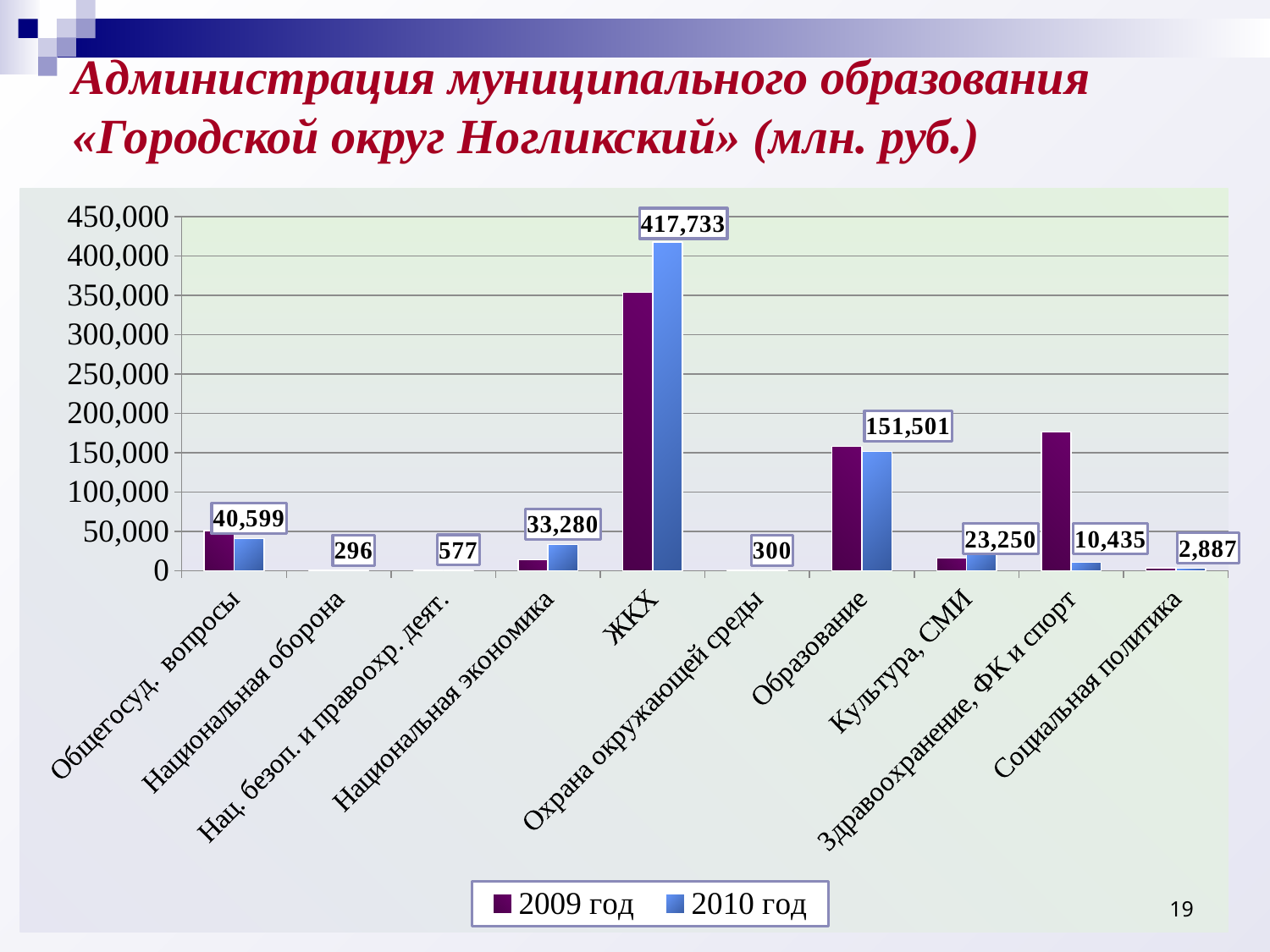
For ЖКХ, which series has the larger value, 2009 год or 2010 год? 2010 год What is the difference between the 2010 год values for Культура, СМИ and Здравоохранение, ФК и спорт? 12,815 What is the value for Национальная оборона in the 2010 год series? 296 What is the difference between the 2010 год values for ЖКХ and Образование? 266,232 Which category has the highest value in the 2010 год series? ЖКХ How many series does the legend list? 2 What is the value for Здравоохранение, ФК и спорт in the 2010 год series? 10,435 What is the value for Образование in the 2010 год series? 151,501 What is the value for ЖКХ in the 2010 год series? 417,733 For Здравоохранение, ФК и спорт, which series has the larger value, 2009 год or 2010 год? 2009 год How many categories are shown on the x axis? 10 Is the 2009 год value for ЖКХ greater or less than 300,000? greater